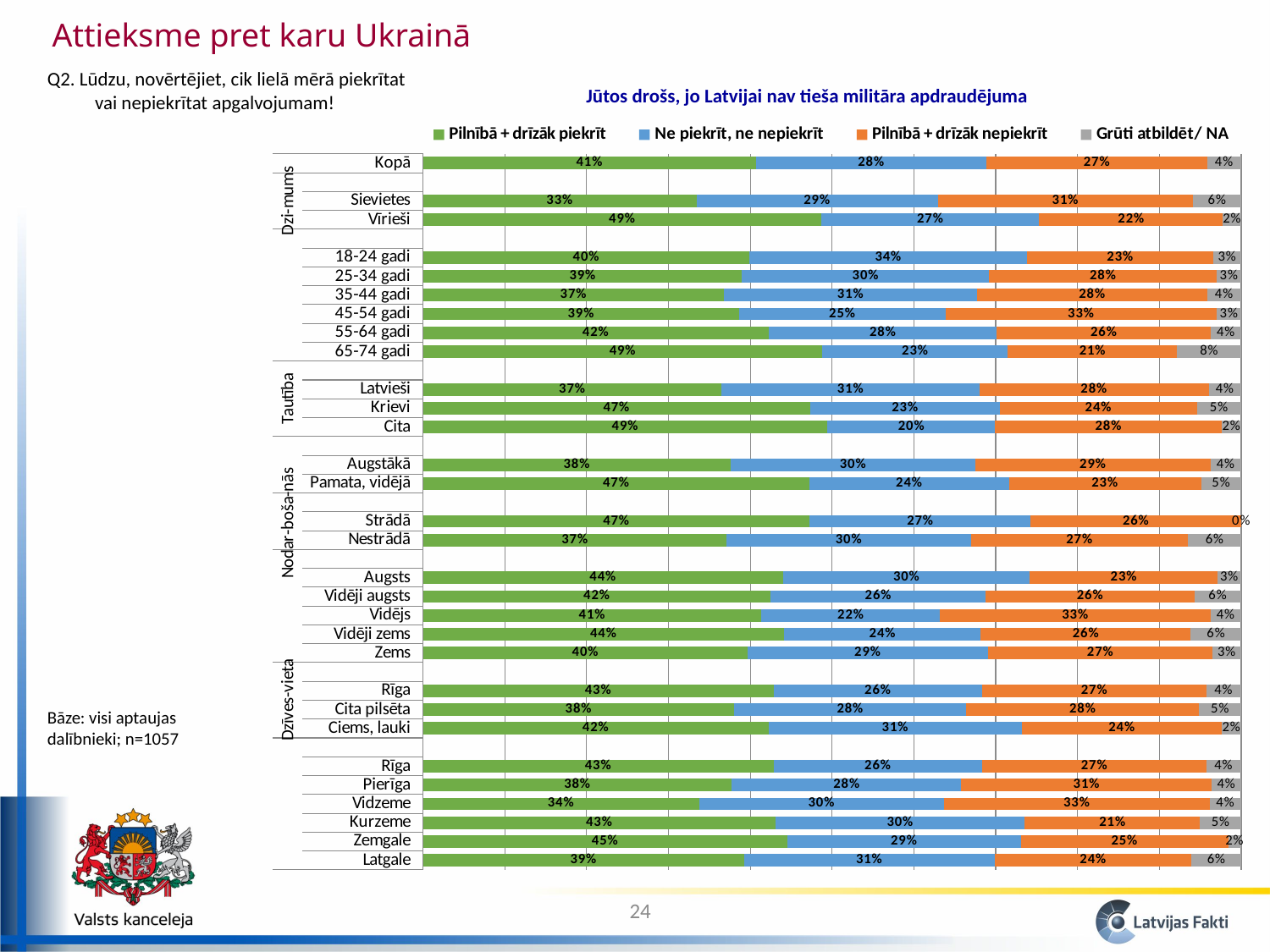
What is the value of "Ne piekrīt, ne nepiekrīt" for Latgale? 31% What kind of chart is shown on the slide? Stacked bar chart Which has a larger value for "Pilnībā + drīzāk piekrīt", Latvieši or Krievi? Krievi What is the difference in "Pilnībā + drīzāk piekrīt" between Vīrieši and Sievietes? 16 percentage points What is the value of "Grūti atbildēt/ NA" for 65-74 gadi? 8% What is the value of "Pilnībā + drīzāk piekrīt" for Kopā? 41% How many series does the legend list? 4 Among the regions Rīga, Pierīga, Vidzeme, Kurzeme, Zemgale and Latgale, which has the lowest value for "Pilnībā + drīzāk piekrīt"? Vidzeme What is the total of the four segments in the Kopā bar? 100% Among the age groups (18-24 gadi to 65-74 gadi), which has the highest value for "Pilnībā + drīzāk piekrīt"? 65-74 gadi What is the value of "Pilnībā + drīzāk nepiekrīt" for Sievietes? 31% What is the title of the chart? Jūtos drošs, jo Latvijai nav tieša militāra apdraudējuma